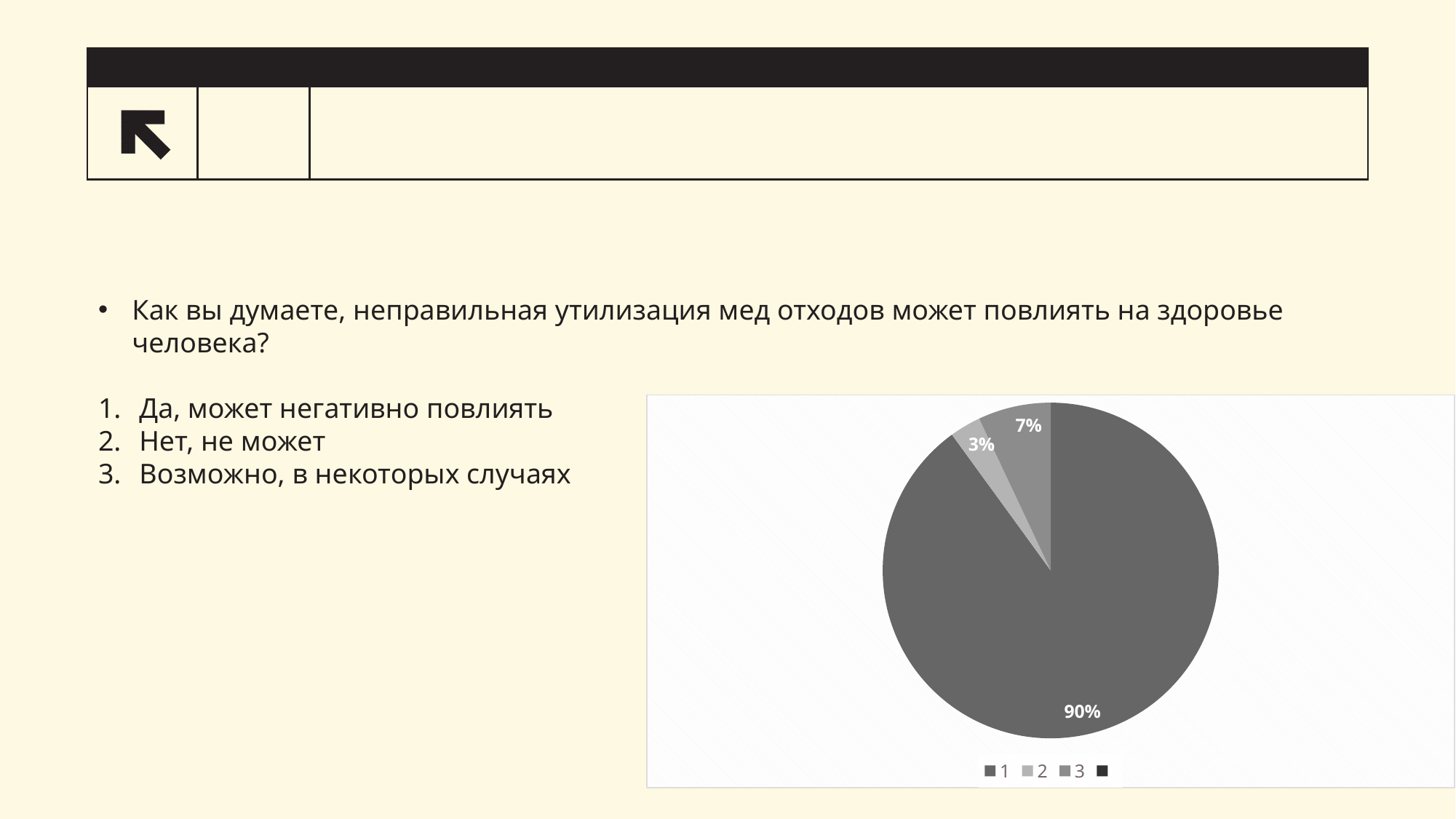
What share of the pie does category 2 have? 3% How many slices with data labels does the pie chart have? 3 What share of the pie does category 3 have? 7% What kind of chart is shown on the slide? pie chart What is the data label printed on the largest slice of the pie? 90% What is the difference in percentage points between the slices for category 3 and category 2? 4% Which slice is larger, category 2 or category 3? 3 What is the difference in percentage points between the slices for category 1 and category 3? 83% Which category has the smallest slice of the pie? 2 Which category has the largest slice of the pie? 1 What share of the pie does category 1 have? 90% What are the labeled entries in the chart legend? 1, 2, 3